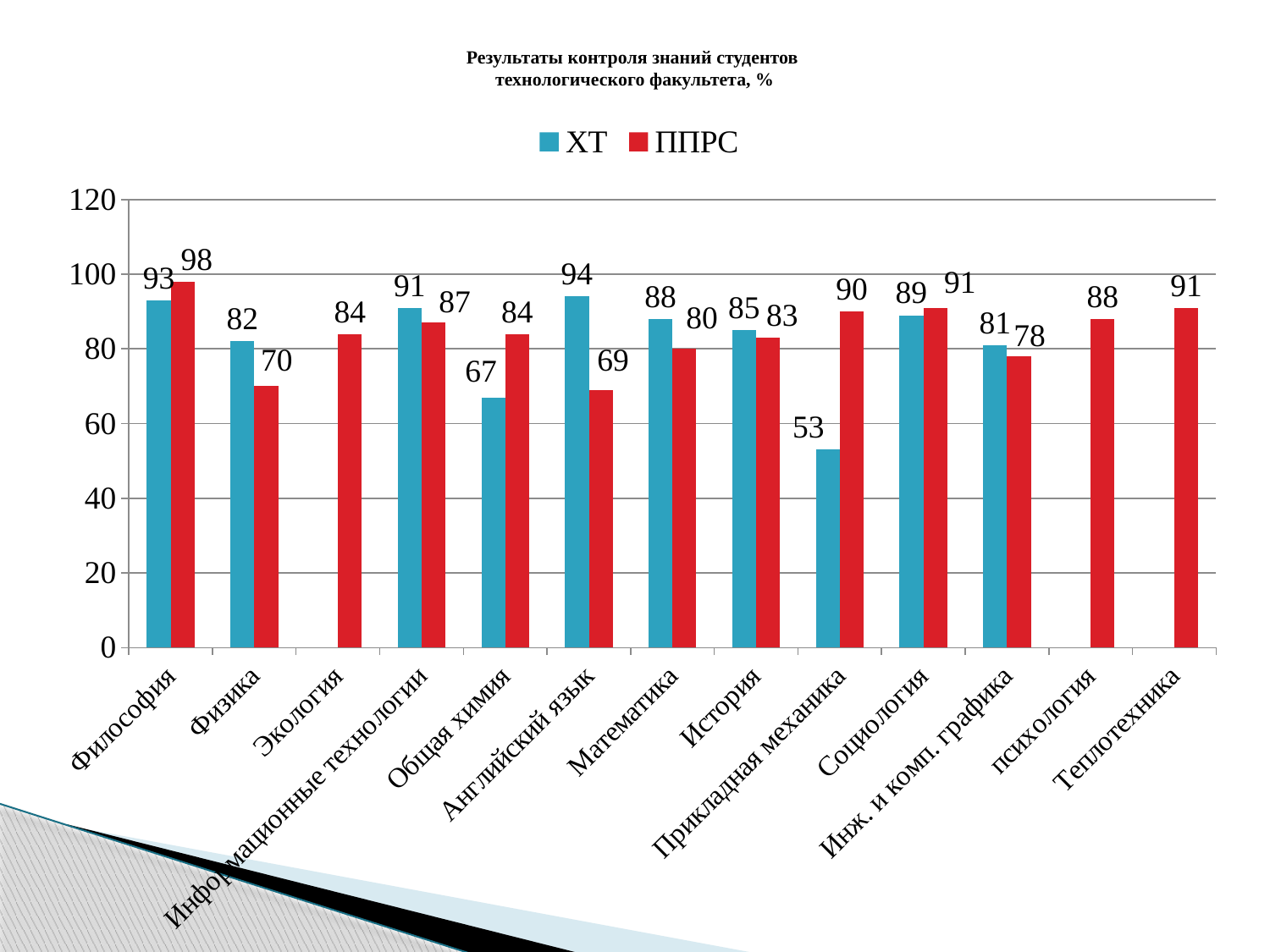
How many categories are shown on the x axis? 13 Which category has the highest ППРС value? Философия What is the ХТ value for Философия? 93 What kind of chart is shown on the slide? Bar chart What is the ППРС value for Прикладная механика? 90 How many series does the legend list? 2 Which category has the lowest ППРС value? Английский язык Which category has the lowest ХТ value? Прикладная механика What is the difference between the ХТ and ППРС values for Прикладная механика? 37 Which category has the highest ХТ value? Английский язык What is the ППРС value for Теплотехника? 91 Which is larger for Физика, the ХТ value or the ППРС value? ХТ